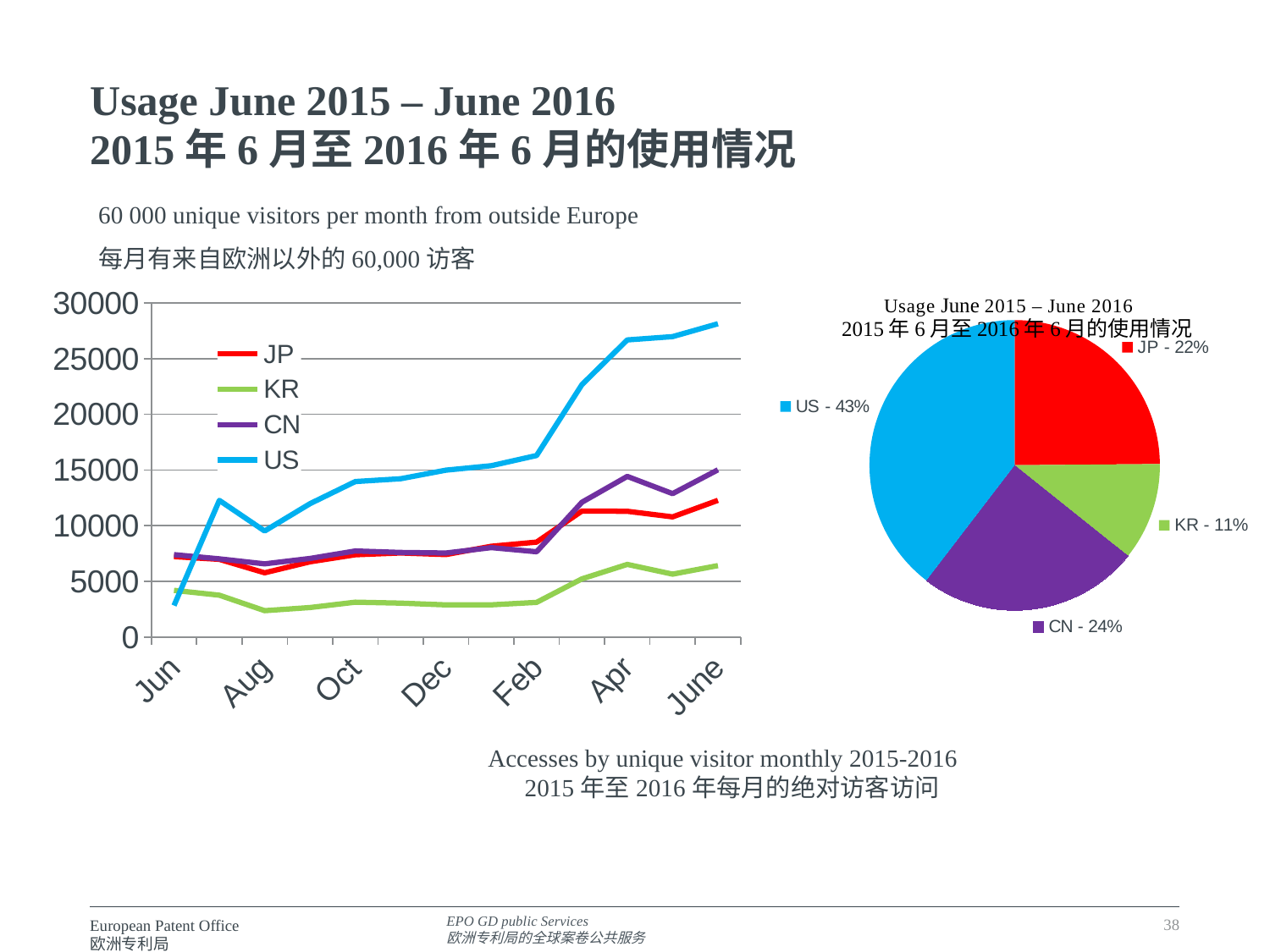
In the line chart on the left, does the US series generally rise or fall from Jun to June? Rise In the pie chart on the right, what is the difference in percentage points between the CN and JP shares? 2% What kind of chart is the chart on the left of the slide? Line chart In the pie chart on the right, what share of usage does KR account for? 11% In the pie chart on the right, what share of usage does US account for? 43% In the pie chart on the right, how many slices are there? 4 In the pie chart on the right, which country has the largest slice? US In the line chart on the left, which series has the highest value in June? US In the line chart on the left, is the value for US in June greater or less than 25000? greater In the pie chart on the right, which country has the smallest slice? KR In the pie chart on the right, what share of usage does CN account for? 24% How many series does the legend of the line chart on the left list? 4